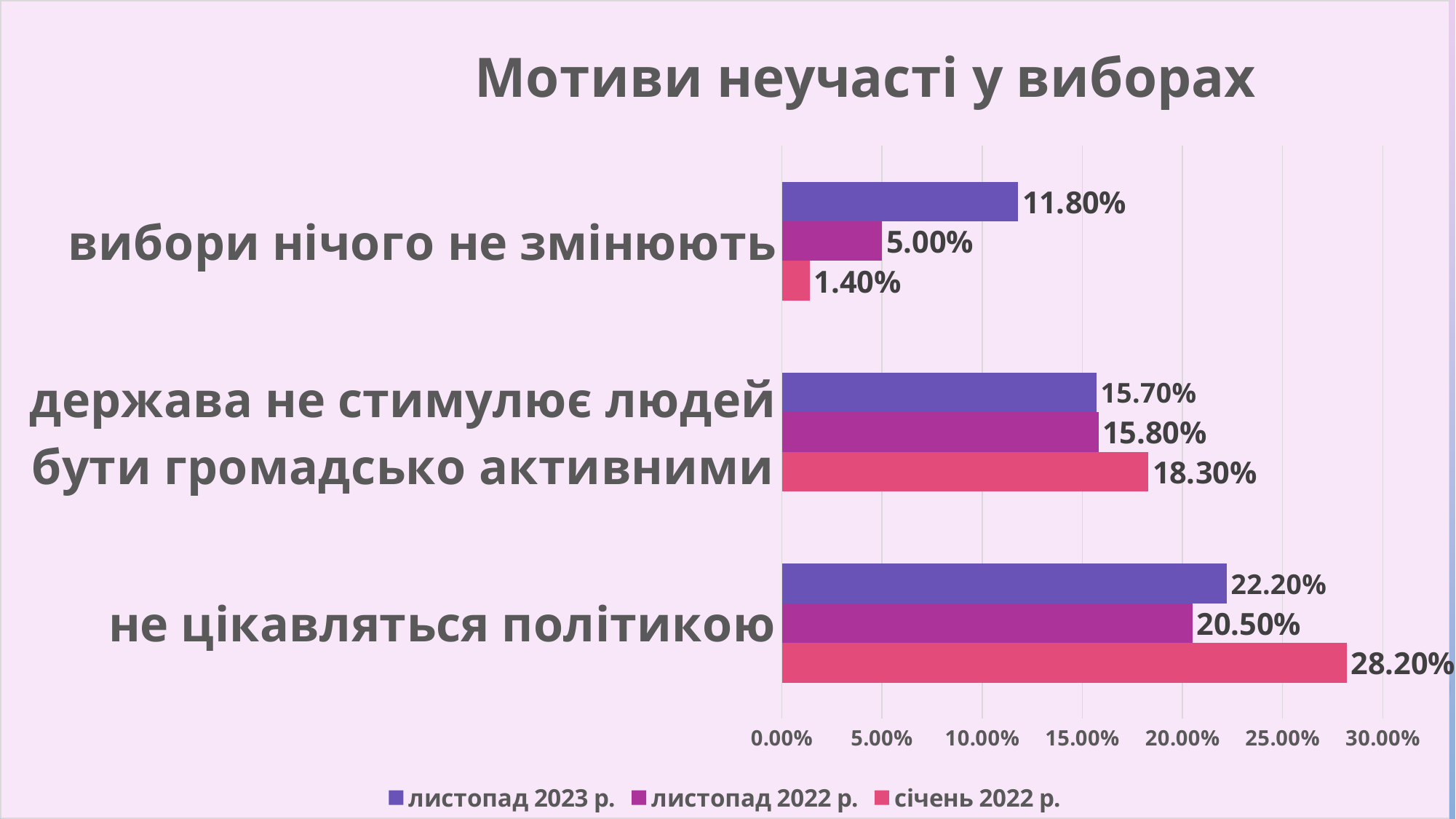
What kind of chart is shown on the slide? bar chart What is the difference between the "січень 2022 р." and "листопад 2022 р." values for "не цікавляться політикою"? 7.70% Which category has the highest value in the "січень 2022 р." series? не цікавляться політикою How many categories are shown on the chart? 3 For "вибори нічого не змінюють", which series has the larger value: "листопад 2023 р." or "січень 2022 р."? листопад 2023 р. What is the title of the chart? Мотиви неучасті у виборах Which category has the lowest value in the "листопад 2023 р." series? вибори нічого не змінюють How many series does the legend list? 3 Is the "січень 2022 р." value for "не цікавляться політикою" greater or less than 25.00%? greater What is the value for "вибори нічого не змінюють" in the "листопад 2023 р." series? 11.80% What is the value for "держава не стимулює людей бути громадсько активними" in the "листопад 2022 р." series? 15.80% What is the value for "не цікавляться політикою" in the "січень 2022 р." series? 28.20%